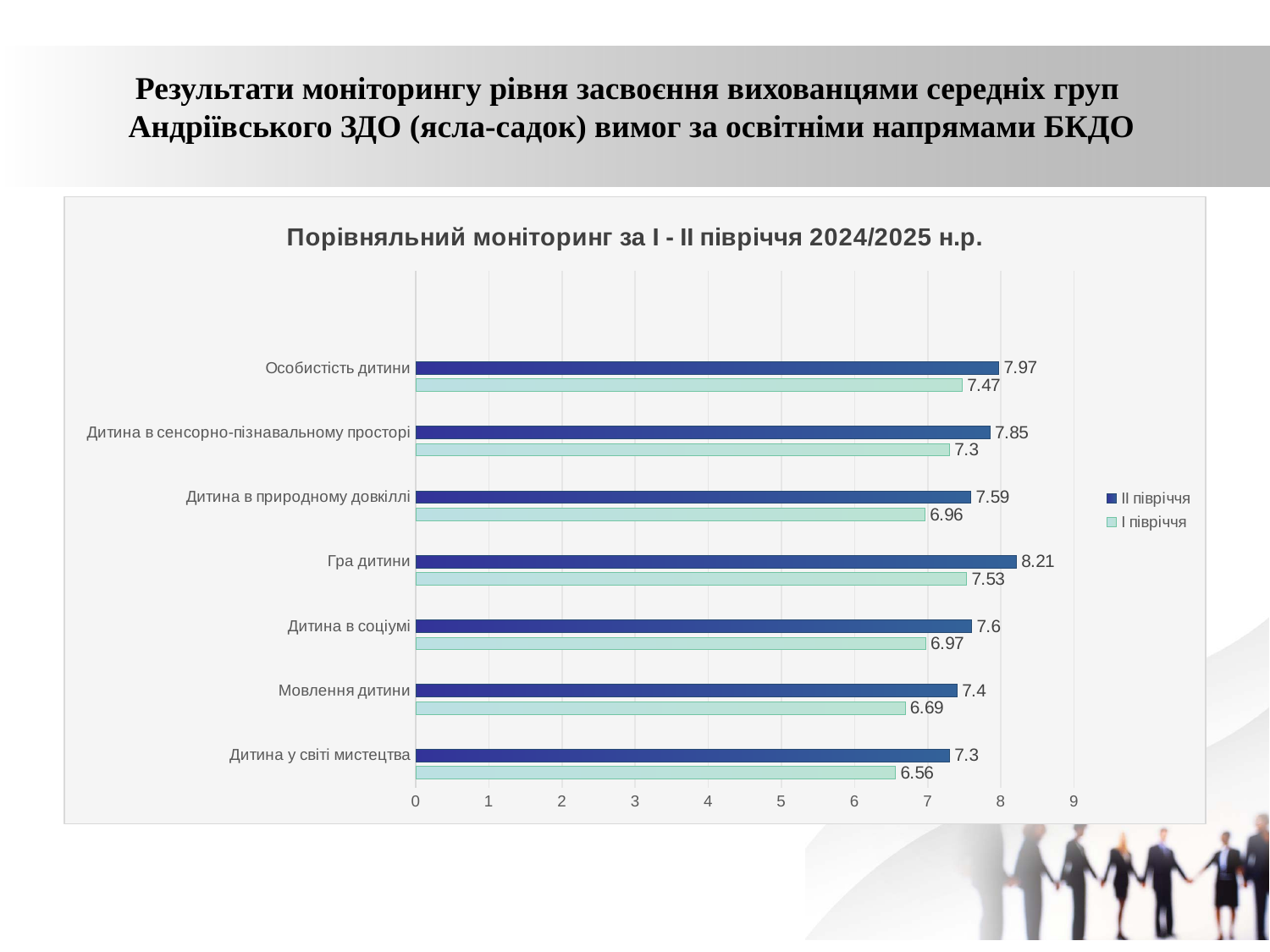
How many series does the legend list? 2 What is the value for "Дитина в природному довкіллі" in the "І півріччя" series? 6.96 What is the difference between the "ІІ півріччя" and "І півріччя" values for "Дитина у світі мистецтва"? 0.74 Which category has the lowest value in the "І півріччя" series? Дитина у світі мистецтва What is the value for "Гра дитини" in the "ІІ півріччя" series? 8.21 What is the value for "Мовлення дитини" in the "І півріччя" series? 6.69 Which is larger for "Особистість дитини": the "ІІ півріччя" value or the "І півріччя" value? ІІ півріччя Which category has the highest value in the "ІІ півріччя" series? Гра дитини What is the title of the chart? Порівняльний моніторинг за І - ІІ півріччя 2024/2025 н.р. How many categories are shown on the chart? 7 Is the "І півріччя" value for "Дитина в соціумі" greater or less than 7? less What type of chart is shown on the slide? bar chart